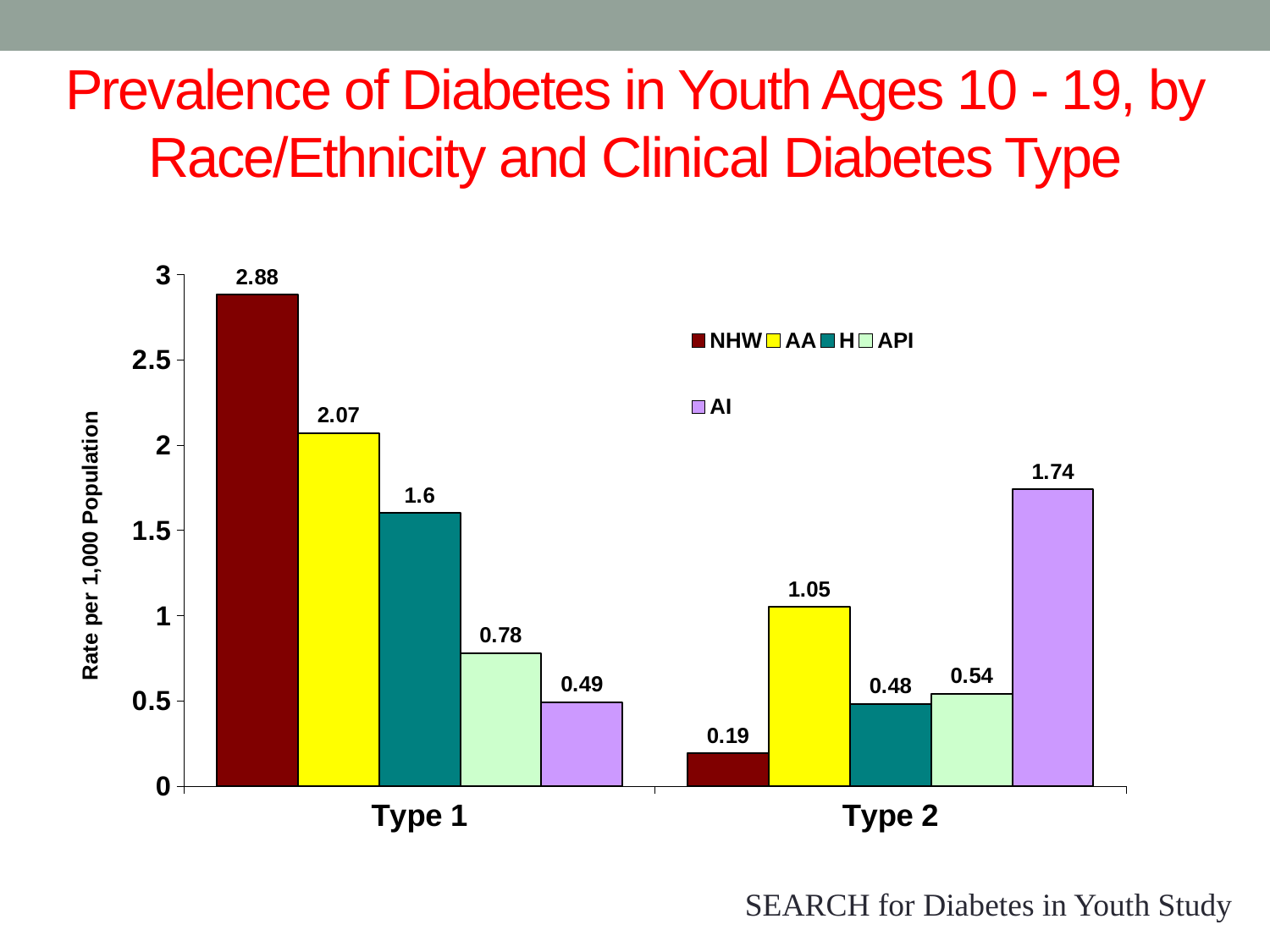
How many diabetes type categories are shown on the x axis? 2 Which race/ethnicity group has the highest rate for Type 1 diabetes? NHW How many series does the legend list? 5 What is the label of the y axis? Rate per 1,000 Population What is the difference between the NHW rate for Type 1 and the NHW rate for Type 2? 2.69 What is the rate per 1,000 population for NHW youth with Type 1 diabetes? 2.88 What is the rate per 1,000 population for H youth with Type 2 diabetes? 0.48 What is the rate per 1,000 population for AI youth with Type 2 diabetes? 1.74 Which race/ethnicity group has the lowest rate for Type 2 diabetes? NHW Is the API rate for Type 1 diabetes greater or less than 1? less What kind of chart is shown on the slide? Bar chart Which is larger: the AA rate for Type 1 or the AI rate for Type 2? AA rate for Type 1